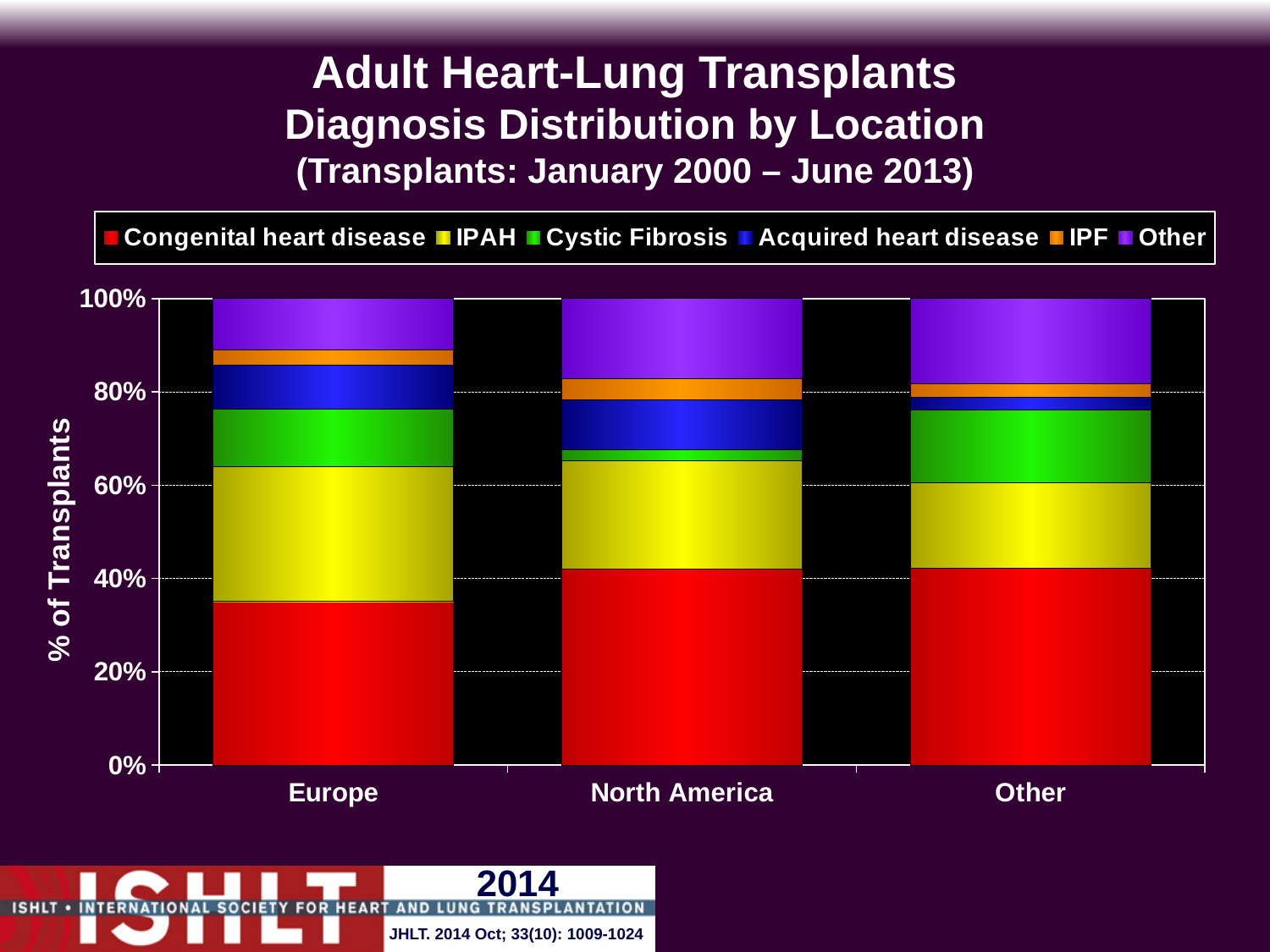
What does each stacked bar total on the y axis? 100% Which location has the smallest Acquired heart disease segment? Other What is the label on the y axis? % of Transplants What kind of chart is shown on the slide? Stacked bar chart Is the Congenital heart disease share for Europe greater or less than 40%? less Is the Cystic Fibrosis share for North America greater or less than 20%? less Which location has the largest IPAH segment? Europe Is the IPAH share for Europe greater or less than 20%? greater Which diagnosis is shown in red in the legend? Congenital heart disease How many location categories are shown along the x axis? 3 How many diagnosis series does the legend list? 6 Which location has the largest Cystic Fibrosis segment, Europe or North America? Europe